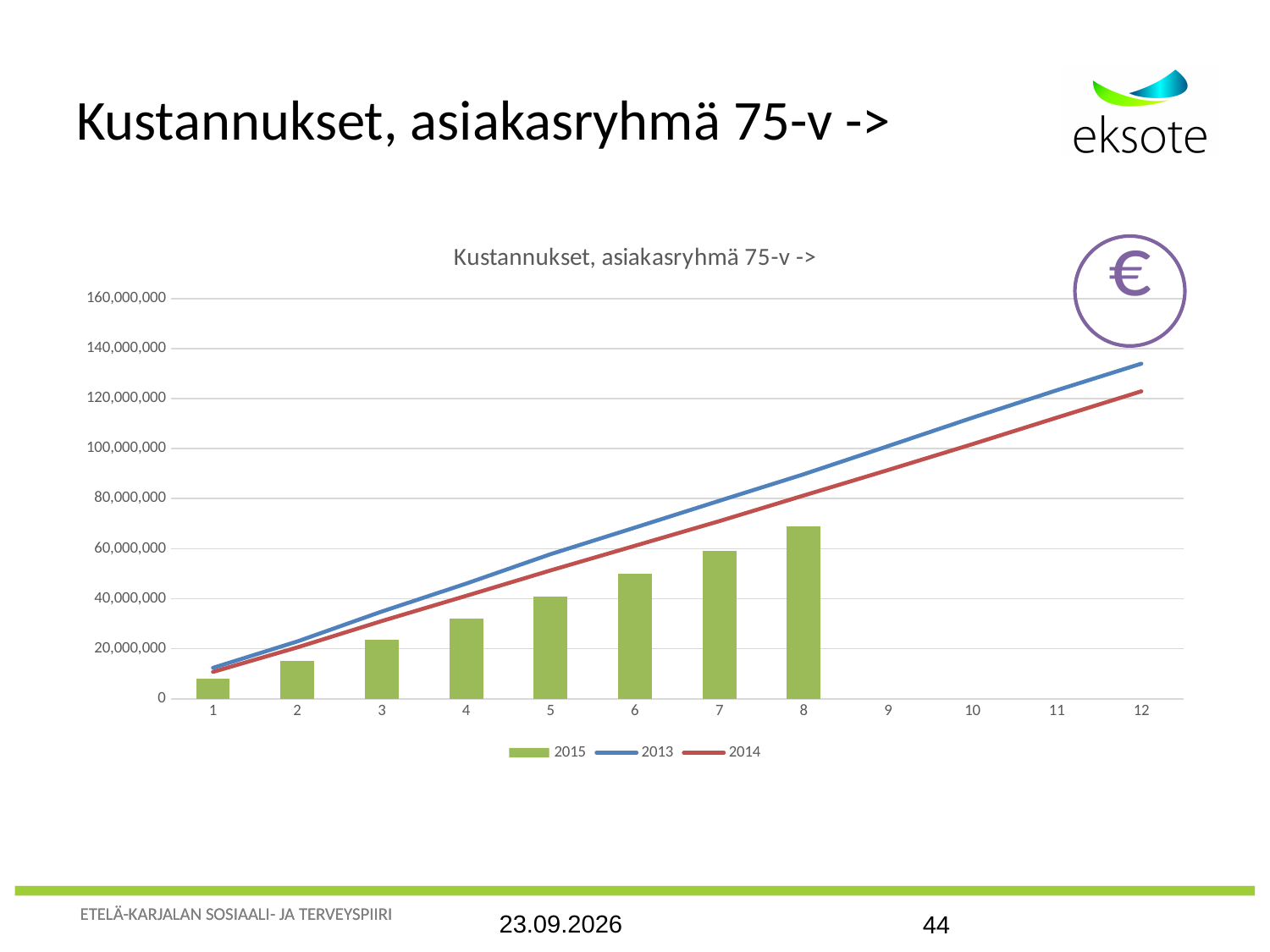
What kind of chart is shown on the slide? A combination bar and line chart How many categories are shown on the x axis? 12 Do the 2013 and 2014 lines rise or fall along the x axis? Rise Is the 2015 value for category 8 greater or less than 60,000,000? greater Is the 2013 value at category 12 greater or less than 120,000,000? greater Which category has the lowest 2015 bar? 1 How many series does the legend list? 3 For how many categories are bars plotted for the 2015 series? 8 Which series are listed in the legend? 2015, 2013, 2014 Which category has the highest 2015 bar? 8 At category 12, which line is higher, 2013 or 2014? 2013 Is the 2015 value for category 1 greater or less than 20,000,000? less